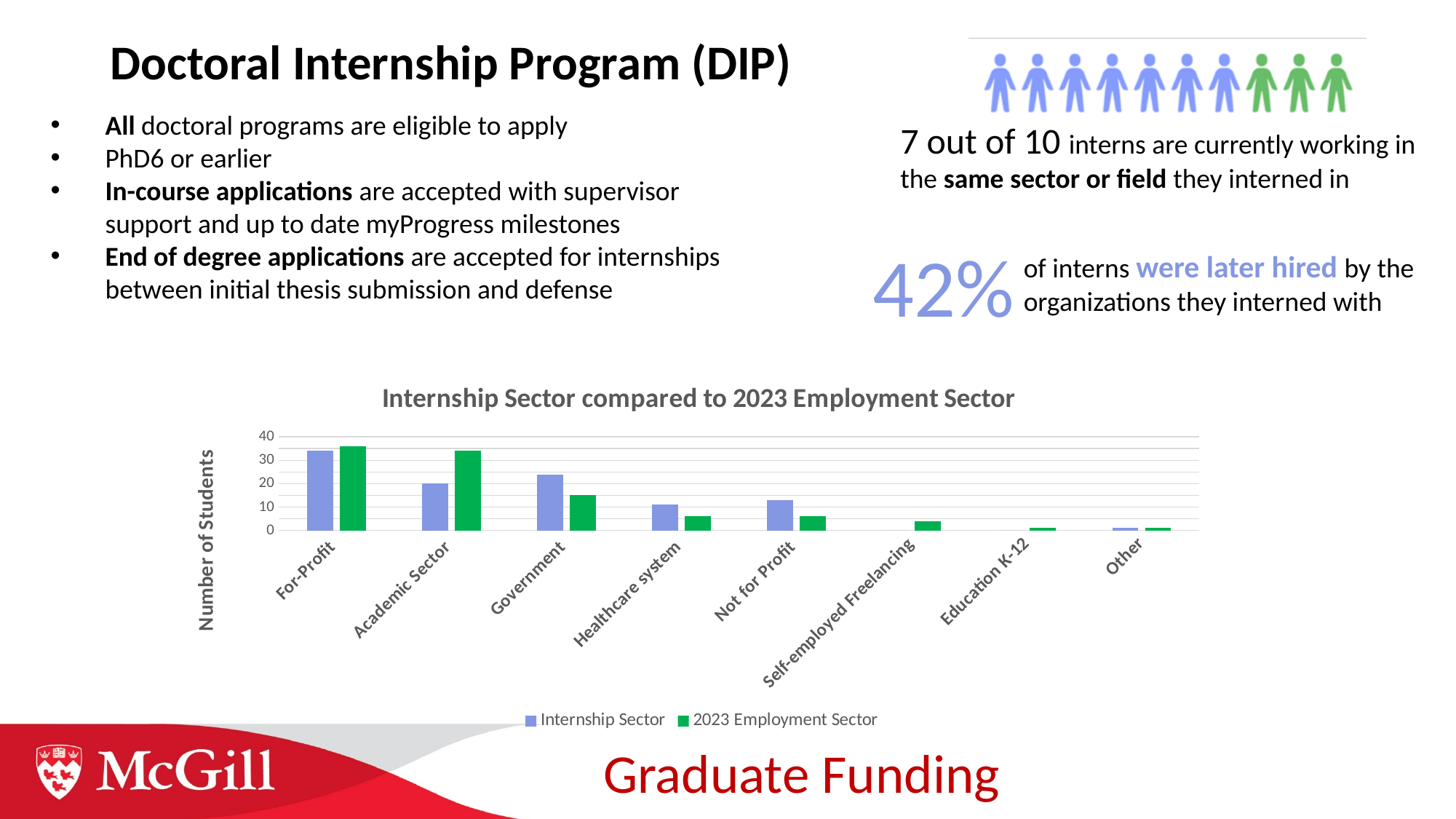
What type of chart is shown on the slide? bar chart For Academic Sector, which is larger: the Internship Sector value or the 2023 Employment Sector value? 2023 Employment Sector What is the title of the chart? Internship Sector compared to 2023 Employment Sector Is the Internship Sector value for Government greater or less than 20? greater For Government, which is larger: the Internship Sector value or the 2023 Employment Sector value? Internship Sector What is the label of the y axis of the chart? Number of Students Which sector has the highest 2023 Employment Sector value? For-Profit Is the 2023 Employment Sector value for Healthcare system greater or less than 10? less How many series does the chart legend list? 2 Which sector has the highest Internship Sector value? For-Profit How many sector categories are shown on the x axis of the chart? 8 Is the 2023 Employment Sector value for Academic Sector greater or less than 30? greater